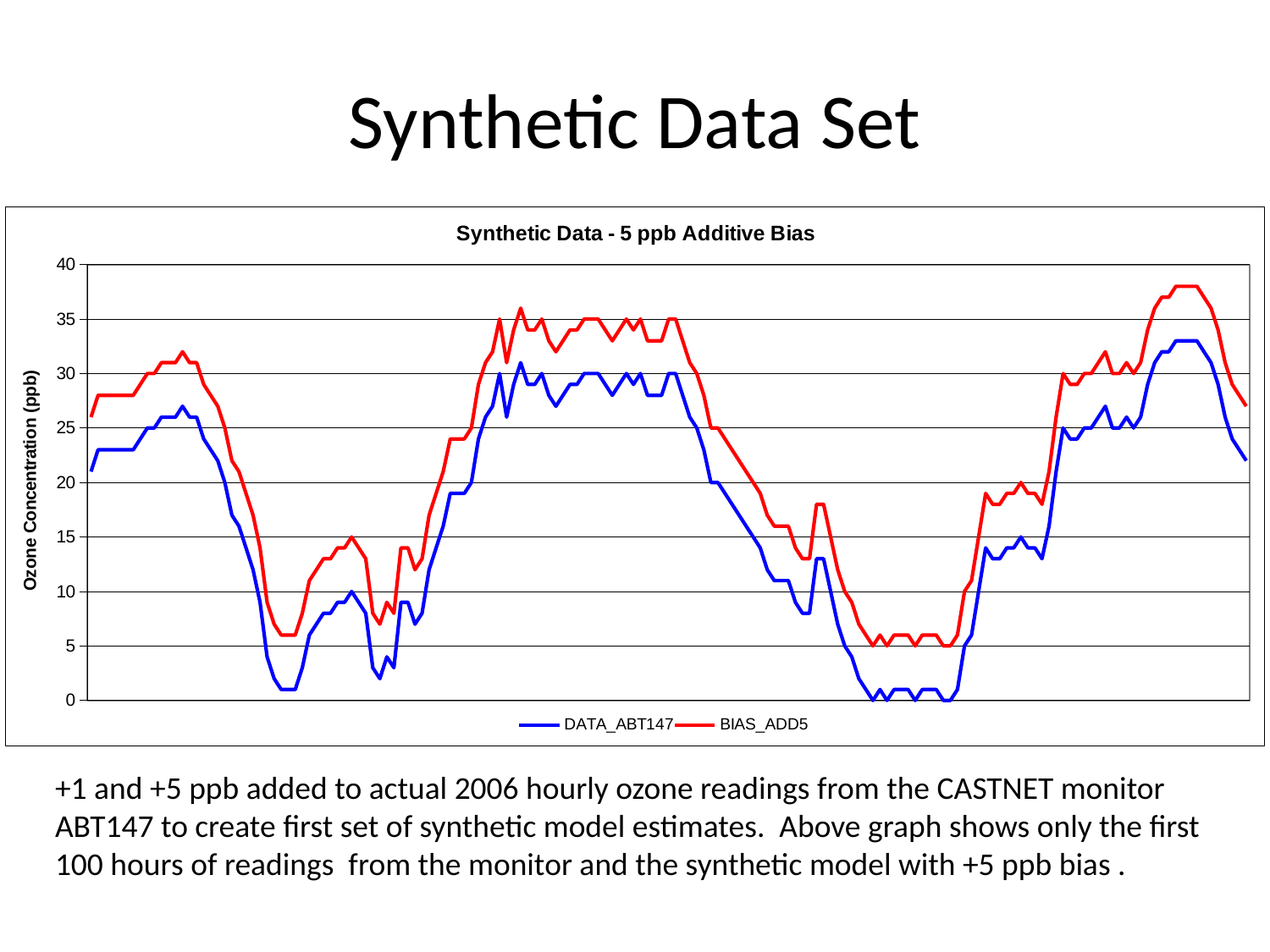
Is the lowest value reached by BIAS_ADD5 greater or less than 10? less Which series reaches the higher peak value, DATA_ABT147 or BIAS_ADD5? BIAS_ADD5 What is the label on the vertical axis of the chart? Ozone Concentration (ppb) Is the last plotted value of BIAS_ADD5 greater or less than 30? less Is the highest value reached by DATA_ABT147 greater or less than 35? less What is the title of the chart? Synthetic Data - 5 ppb Additive Bias Which series has the lower values throughout the chart, DATA_ABT147 or BIAS_ADD5? DATA_ABT147 How many series does the chart legend list? 2 What kind of chart is shown on the slide? line chart